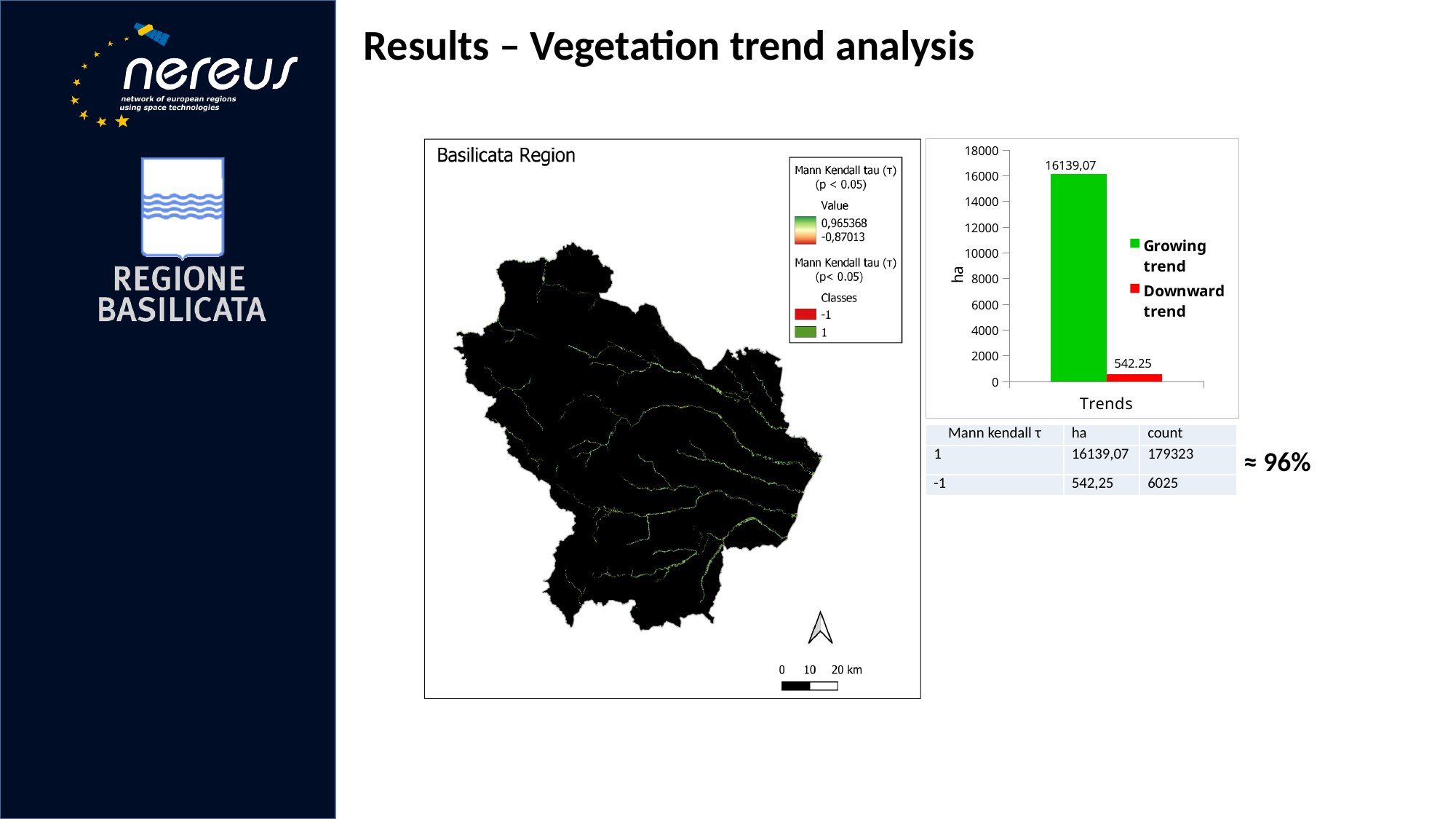
What colour is the Downward trend bar in the bar chart? red How many series does the legend of the bar chart list? 2 What is the value for Growing trend in the bar chart? 16139,07 What kind of chart is shown next to the map? bar chart What is the label of the y axis of the bar chart? ha Is the value for Growing trend greater or less than 14000? greater Is the value for Downward trend greater or less than 2000? less Which is larger in the bar chart, Growing trend or Downward trend? Growing trend How many bars are plotted in the bar chart? 2 Which series has the highest value in the bar chart? Growing trend What is the value for Downward trend in the bar chart? 542.25 Which series has the lowest value in the bar chart? Downward trend